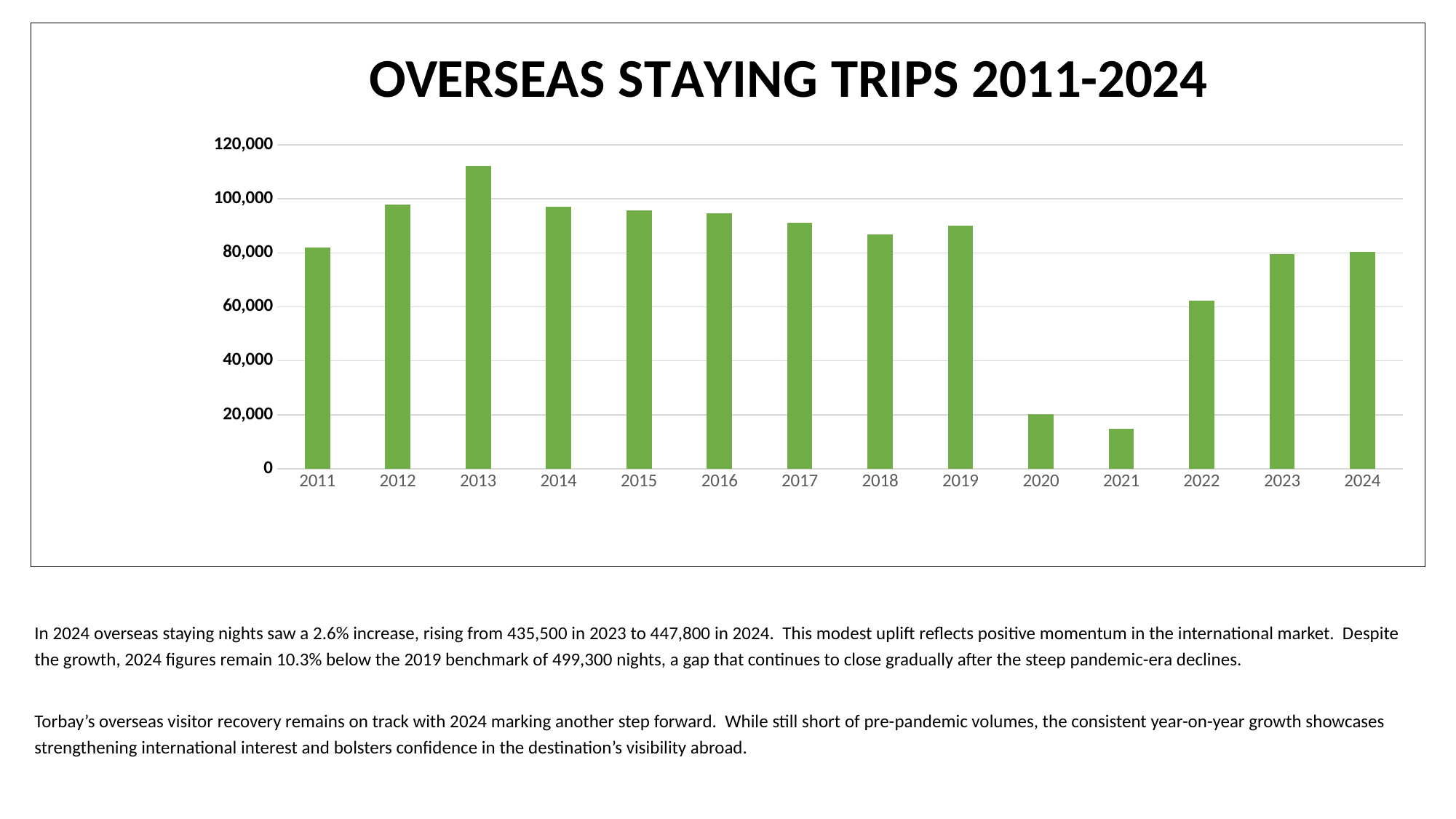
Is the value for 2013 greater or less than 100,000? greater How many years are plotted on the chart? 14 Which year has the lowest number of overseas staying trips? 2021 Is the value for 2018 greater or less than 80,000? greater Which year has more overseas staying trips, 2011 or 2012? 2012 Which year has more overseas staying trips, 2020 or 2022? 2022 What is the title of the chart? OVERSEAS STAYING TRIPS 2011-2024 What kind of chart is shown on the slide? Bar chart Do the values rise or fall from 2021 to 2024? Rise Is the value for 2022 greater or less than 80,000? less Which year has the highest number of overseas staying trips? 2013